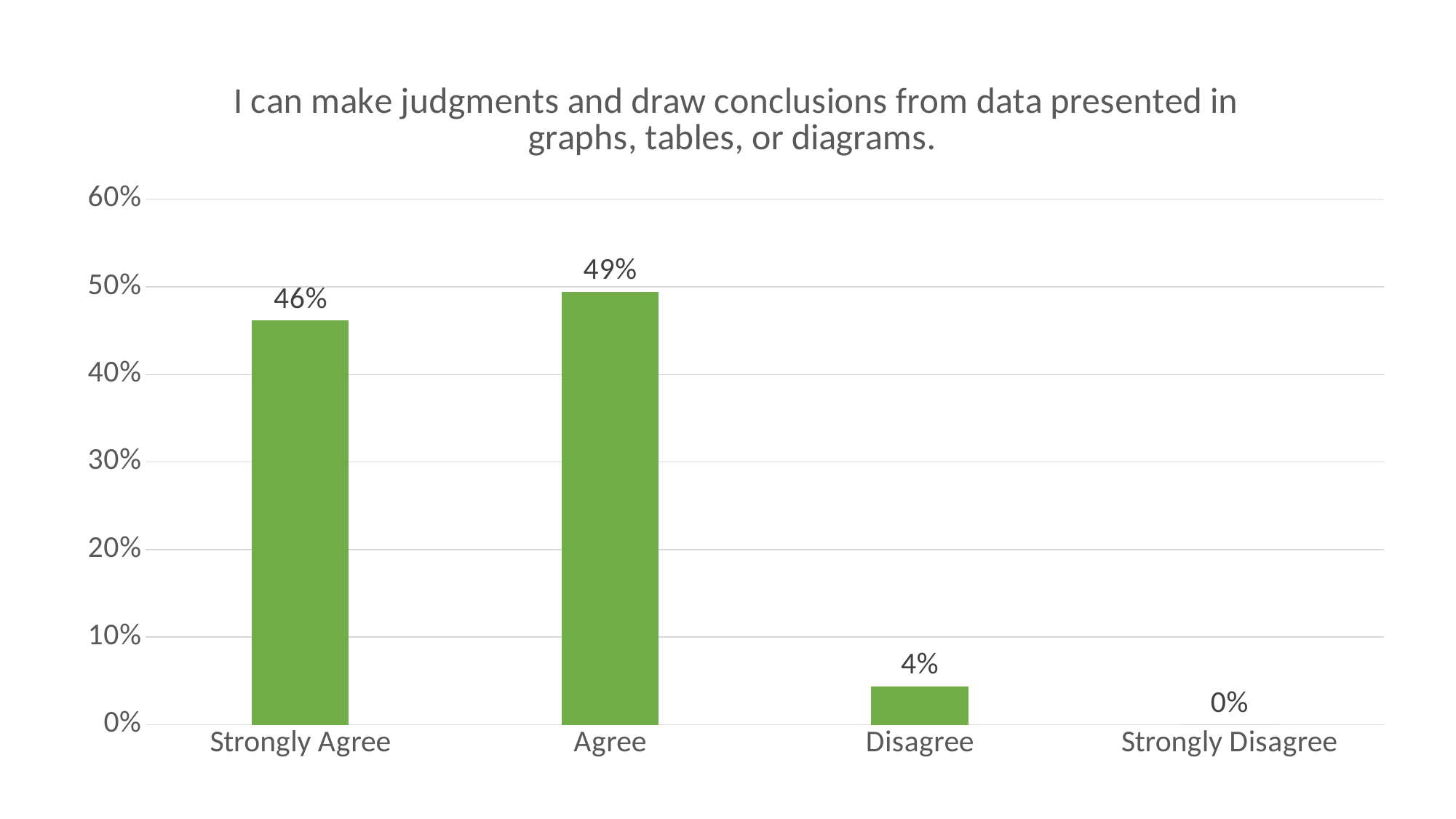
What is the value for Disagree? 4% How many categories are shown on the x axis? 4 What is the value for Strongly Disagree? 0% Which category has the lowest value? Strongly Disagree What kind of chart is shown on the slide? bar chart What is the difference between the values for Agree and Strongly Agree? 3% What is the value for Agree? 49% Which category has the highest value? Agree What is the value for Strongly Agree? 46% Which is larger, the value for Strongly Agree or the value for Disagree? Strongly Agree Is the value for Agree greater or less than 40%? greater What is the title of the chart? I can make judgments and draw conclusions from data presented in graphs, tables, or diagrams.